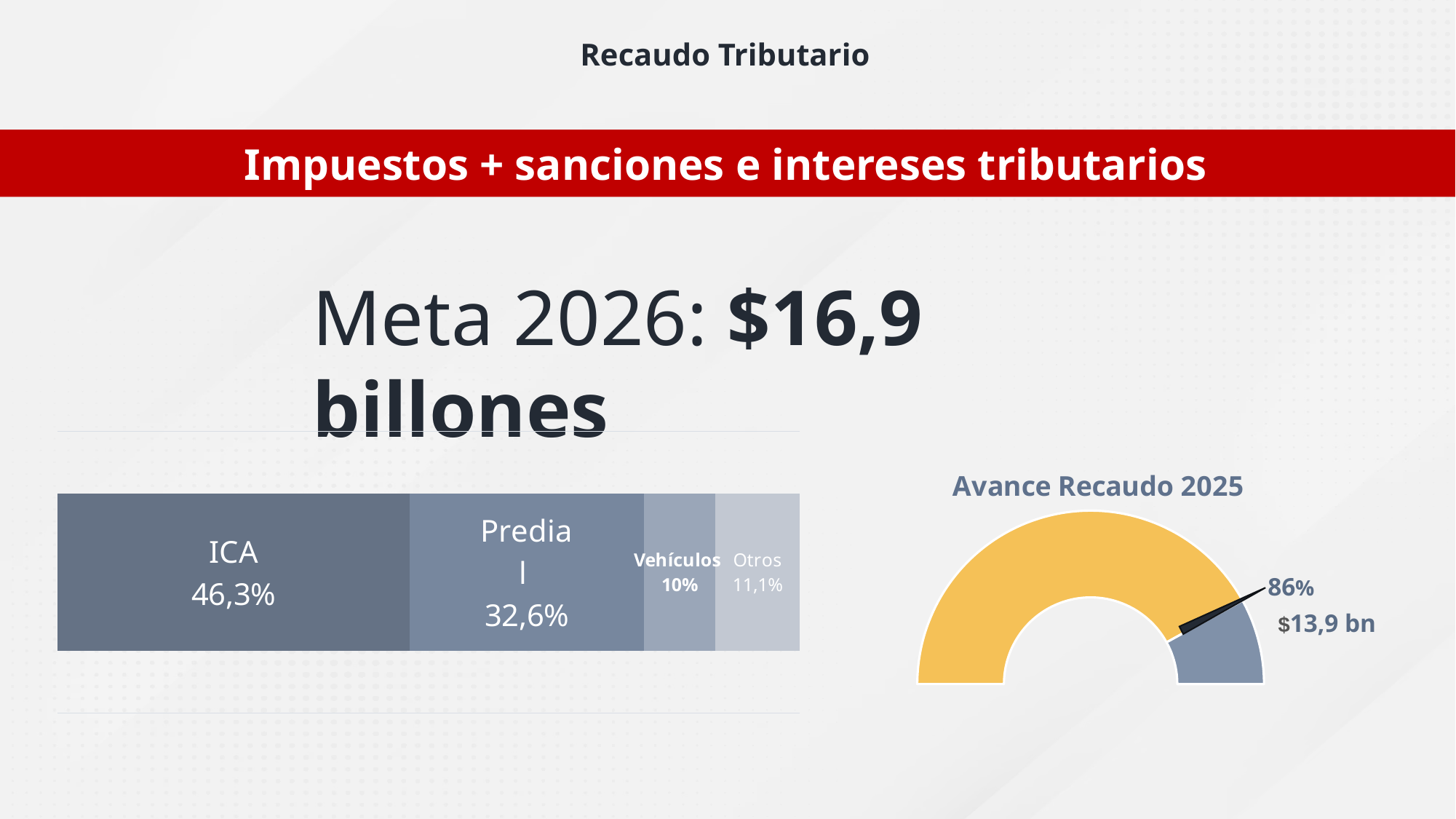
In the stacked bar chart on the left, which is larger, Otros or Vehículos? Otros How many segments does the stacked bar chart on the left have? 4 In the stacked bar chart on the left, what share does Vehículos represent? 10% In the gauge chart titled 'Avance Recaudo 2025', what percentage does the needle indicate? 86% In the stacked bar chart on the left, what share does ICA represent? 46,3% In the gauge chart titled 'Avance Recaudo 2025', what amount is shown next to the needle? $13,9 bn What kind of chart is shown on the left of the slide? Stacked bar chart In the stacked bar chart on the left, what is the difference between the ICA share and the Predial share? 13,7% In the stacked bar chart on the left, which segment is the largest? ICA In the stacked bar chart on the left, what share does Otros represent? 11,1% In the stacked bar chart on the left, what share does Predial represent? 32,6% In the stacked bar chart on the left, which segment is the smallest? Vehículos